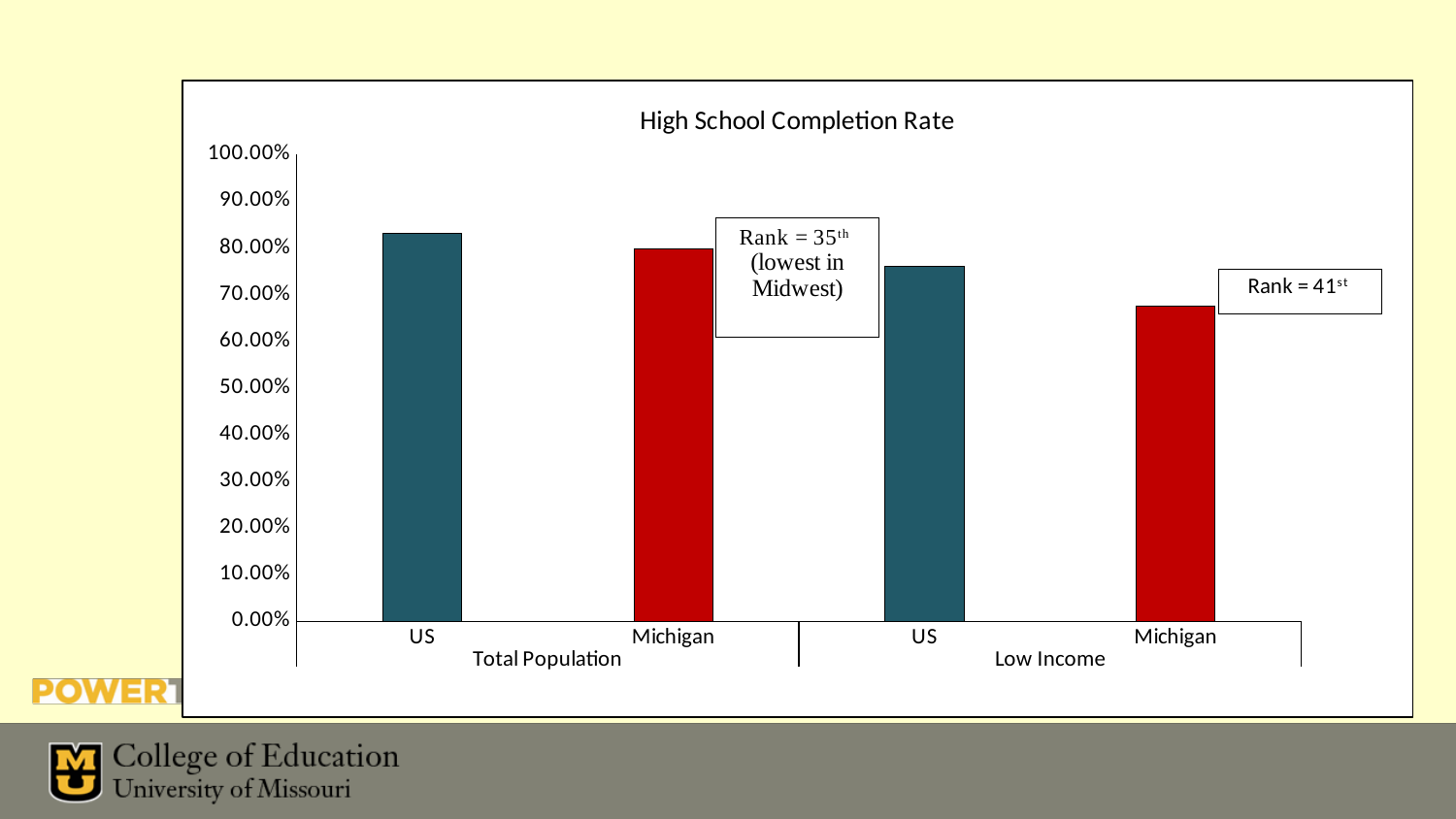
Is the value for Michigan in the Total Population group greater or less than 90.00%? less Is the value for Michigan in the Low Income group greater or less than 70.00%? less What rank is shown in the annotation next to the Low Income Michigan bar? Rank = 41st What kind of chart is shown on the slide? bar chart How many bars are plotted in the chart? 4 What is the title of the chart? High School Completion Rate Is the value for US in the Total Population group greater or less than 80.00%? greater Which bar has the highest high school completion rate? US (Total Population) Which is larger: the US value or the Michigan value in the Low Income group? US Which bar has the lowest high school completion rate? Michigan (Low Income) Do the bar values rise or fall from left to right across the chart? fall